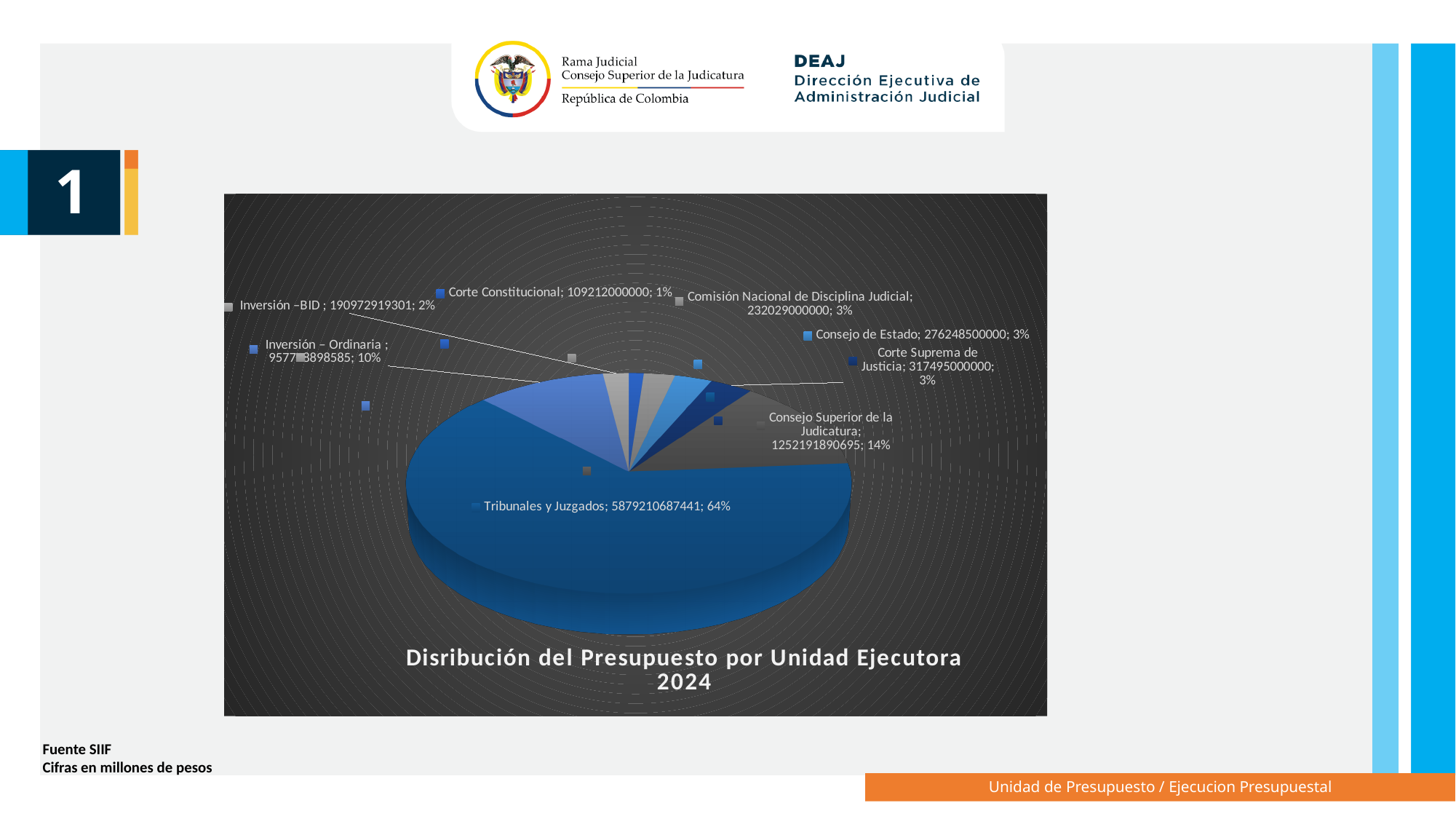
What is the value shown for Corte Suprema de Justicia? 317495000000 What is the difference between the value for Corte Suprema de Justicia and the value for Consejo de Estado? 41246500000 What is the title of the chart? Disribución del Presupuesto por Unidad Ejecutora 2024 What is the value shown for Consejo Superior de la Judicatura? 1252191890695 What is the value shown for Tribunales y Juzgados? 5879210687441 Which category has the smallest share of the pie? Corte Constitucional Which is larger, the value for Consejo de Estado or the value for Comisión Nacional de Disciplina Judicial? Consejo de Estado What percentage share of the pie does Inversión –BID have? 2% How many categories (slices) does the pie chart show? 8 What percentage share of the pie does Consejo Superior de la Judicatura have? 14% Which category has the largest share of the pie? Tribunales y Juzgados What kind of chart is shown on the slide? Pie chart